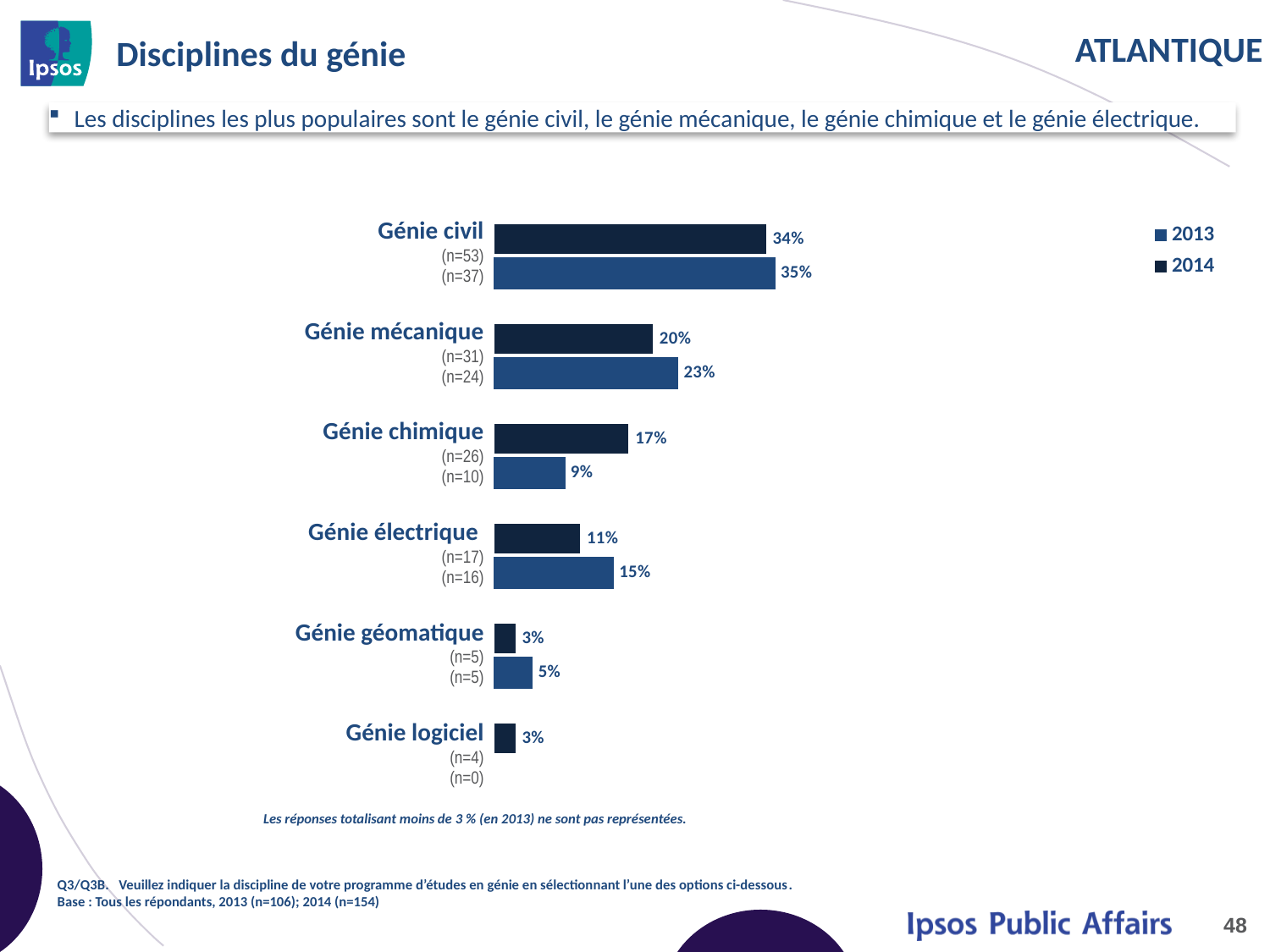
What is the difference between the 2013 and 2014 values for Génie chimique? 8 percentage points What is the value for Génie chimique in 2013? 17% Which discipline has the highest value in 2013? Génie civil What is the value for Génie civil in 2014? 35% What is the difference between the 2014 values for Génie civil and Génie mécanique? 12 percentage points How many disciplines are listed on the chart? 6 Which discipline has the lowest value in 2014 among those with a 2014 bar? Génie géomatique How many series does the legend list? 2 What is the value for Génie électrique in 2014? 15% What kind of chart is shown on the slide? Bar chart Which is larger for Génie électrique: the 2013 value or the 2014 value? 2014 Which is larger: Génie mécanique in 2013 or Génie chimique in 2013? Génie mécanique in 2013